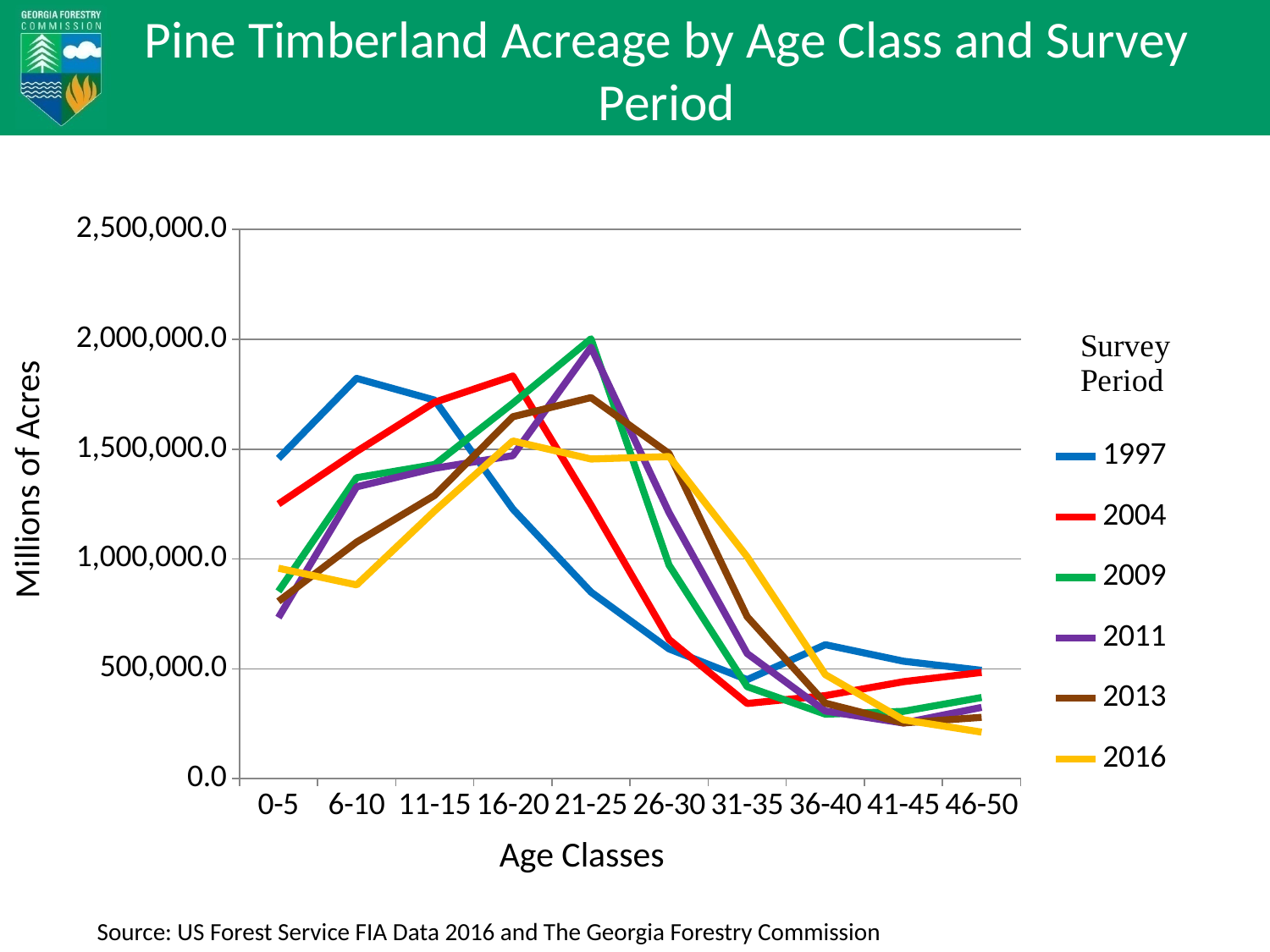
Does the 1997 line rise or fall from age class 6-10 to age class 36-40? Fall How many survey periods does the legend list? 6 What kind of chart is shown on the slide? Line chart Is the value for the 2004 survey period at age class 31-35 greater or less than 500,000.0? less In which age class does the 2009 survey period reach its highest value? 21-25 How many age classes are shown on the x axis? 10 Is the value for the 2016 survey period at age class 0-5 greater or less than 1,000,000.0? less What is the label on the vertical axis of the chart? Millions of Acres Is the value for the 2013 survey period at age class 21-25 greater or less than 1,500,000.0? greater At age class 0-5, which survey period has the larger value, 1997 or 2016? 1997 In which age class does the 1997 survey period reach its highest value? 6-10